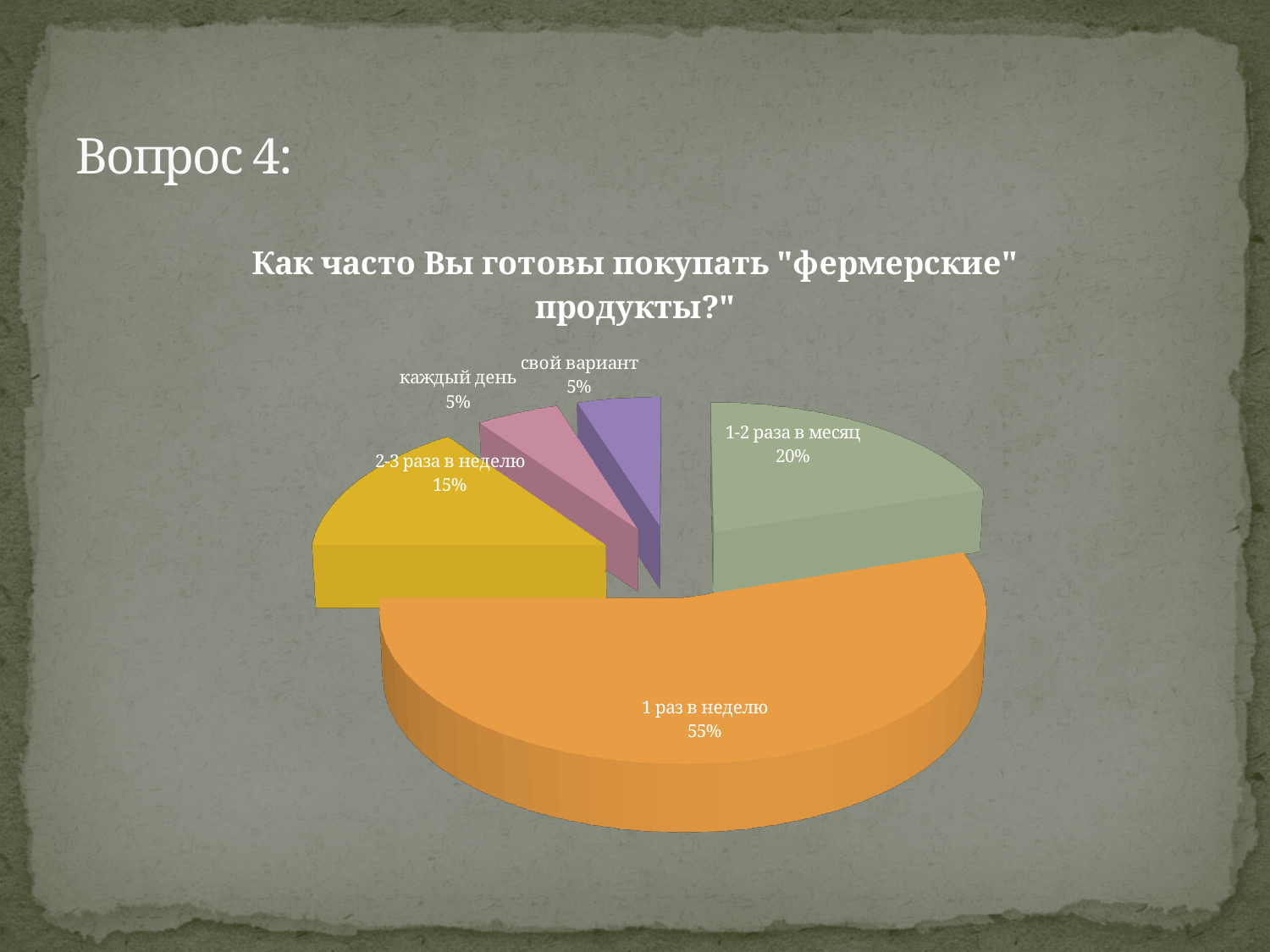
What is the value shown for "1-2 раза в месяц"? 20% What colour is the slice for "1 раз в неделю"? Orange What is the title of the chart? Как часто Вы готовы покупать "фермерские" продукты?" How many categories are shown in the pie chart? 5 What is the value shown for "2-3 раза в неделю"? 15% Which category has the largest slice of the pie? 1 раз в неделю What is the value shown for "каждый день"? 5% What share of the pie does "1 раз в неделю" have? 55% Which is larger, the share for "2-3 раза в неделю" or the share for "1-2 раза в месяц"? 1-2 раза в месяц What is the combined share of "каждый день" and "свой вариант"? 10% What kind of chart is shown on the slide? Pie chart What is the difference between the shares of "1 раз в неделю" and "1-2 раза в месяц"? 35%